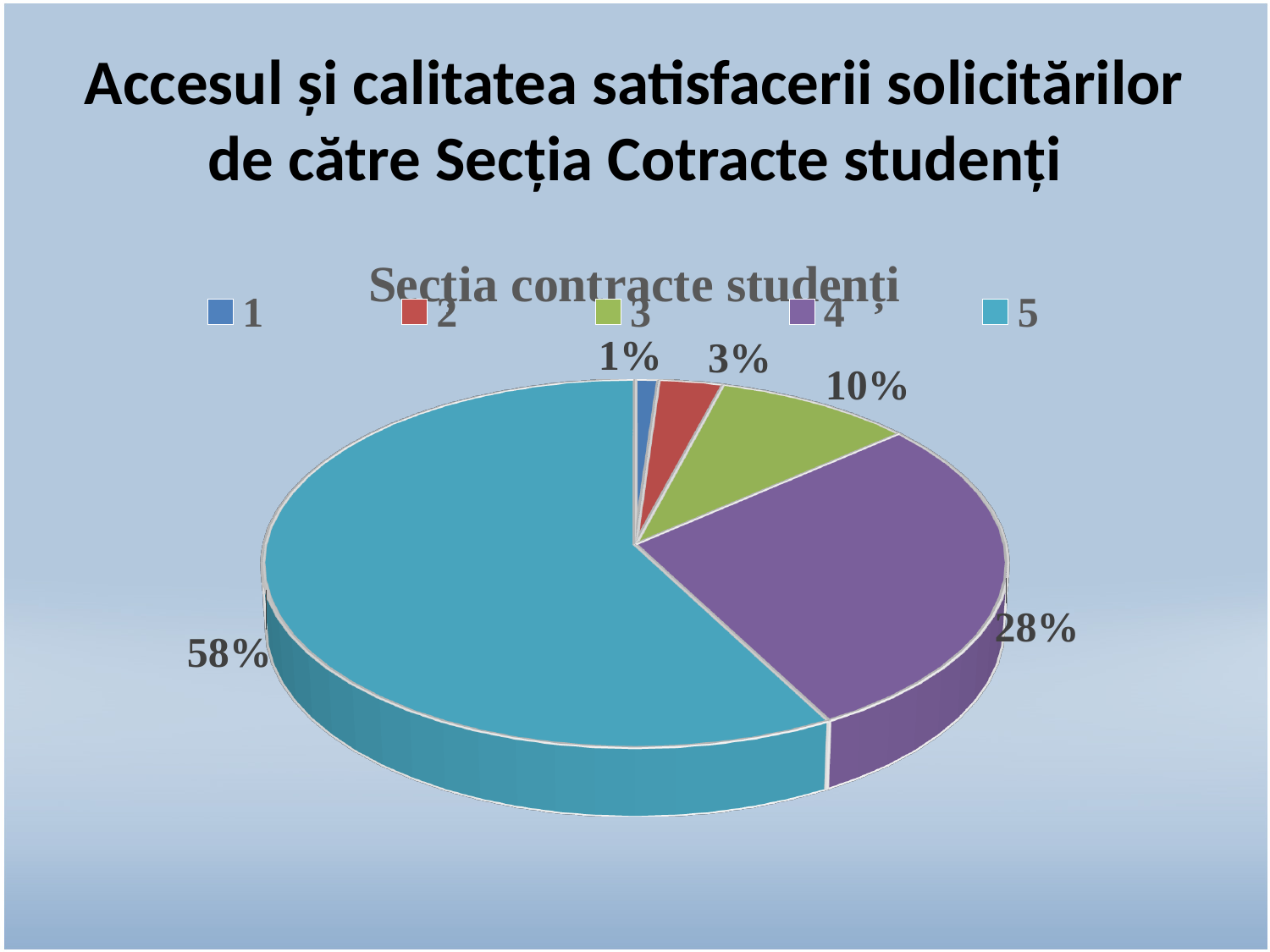
What is the difference between the shares of category 5 and category 4? 30% How many categories does the legend list? 5 Which is larger, the slice for category 3 or the slice for category 2? 3 What is the value for category 1? 1% Which category has the smallest slice? 1 What share of the pie does category 5 have? 58% What share of the pie does category 4 have? 28% What kind of chart is shown on the slide? pie chart What is the chart's title? Secția contracte studenți Which category has the largest slice? 5 What is the value for category 3? 10% What is the value for category 2? 3%